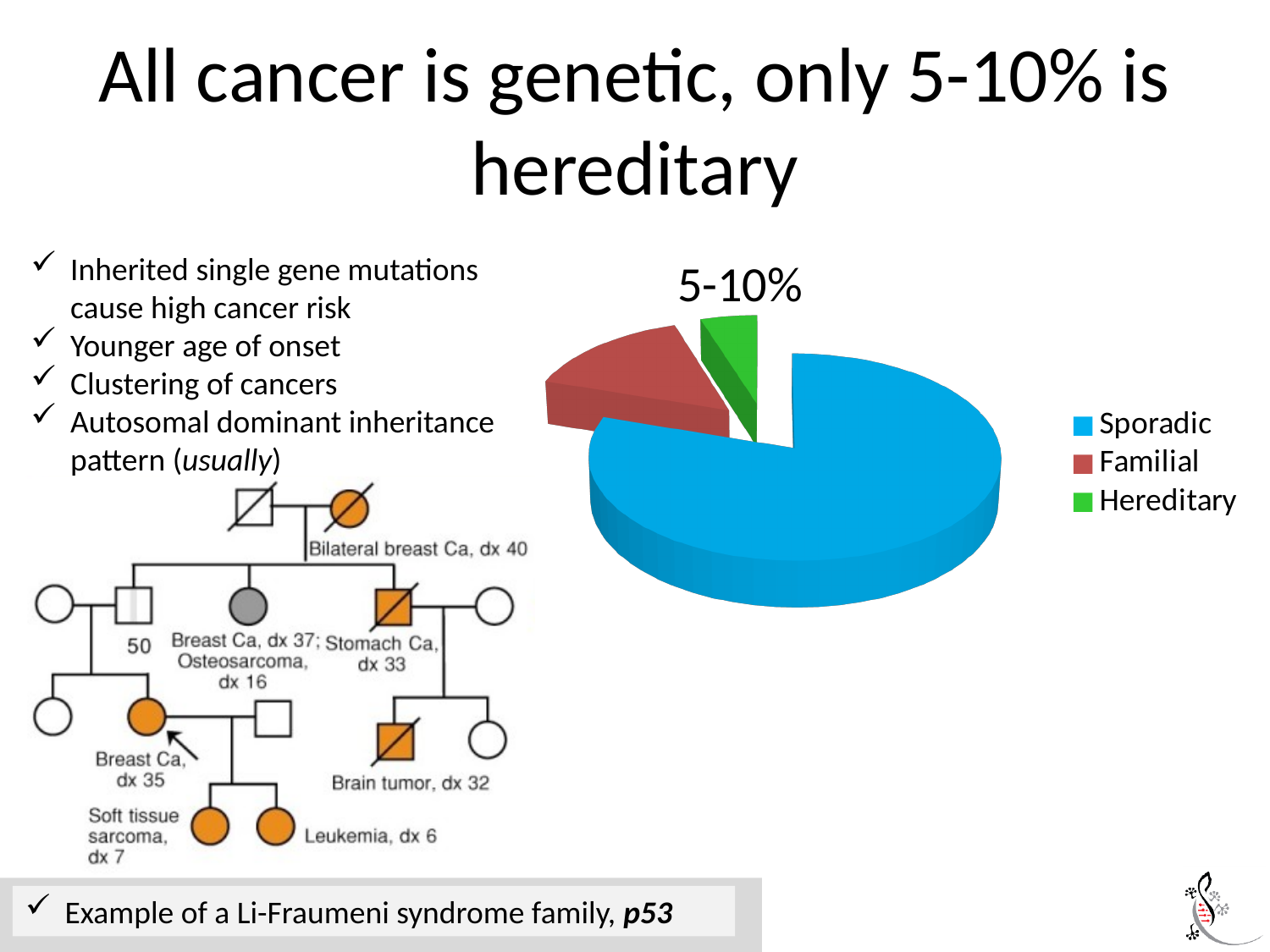
Which slice is larger in the pie chart, Familial or Hereditary? Familial What percentage label is printed above the pie chart next to the Hereditary slice? 5-10% Which slice is smaller in the pie chart, Sporadic or Hereditary? Hereditary Which slice is larger in the pie chart, Sporadic or Familial? Sporadic What kind of chart is shown on the right of the slide? pie chart Which category has the largest slice in the pie chart? Sporadic What colour is the Hereditary slice in the pie chart? green What colour is the Sporadic slice in the pie chart? blue Which category has the smallest slice in the pie chart? Hereditary How many categories does the pie chart's legend list? 3